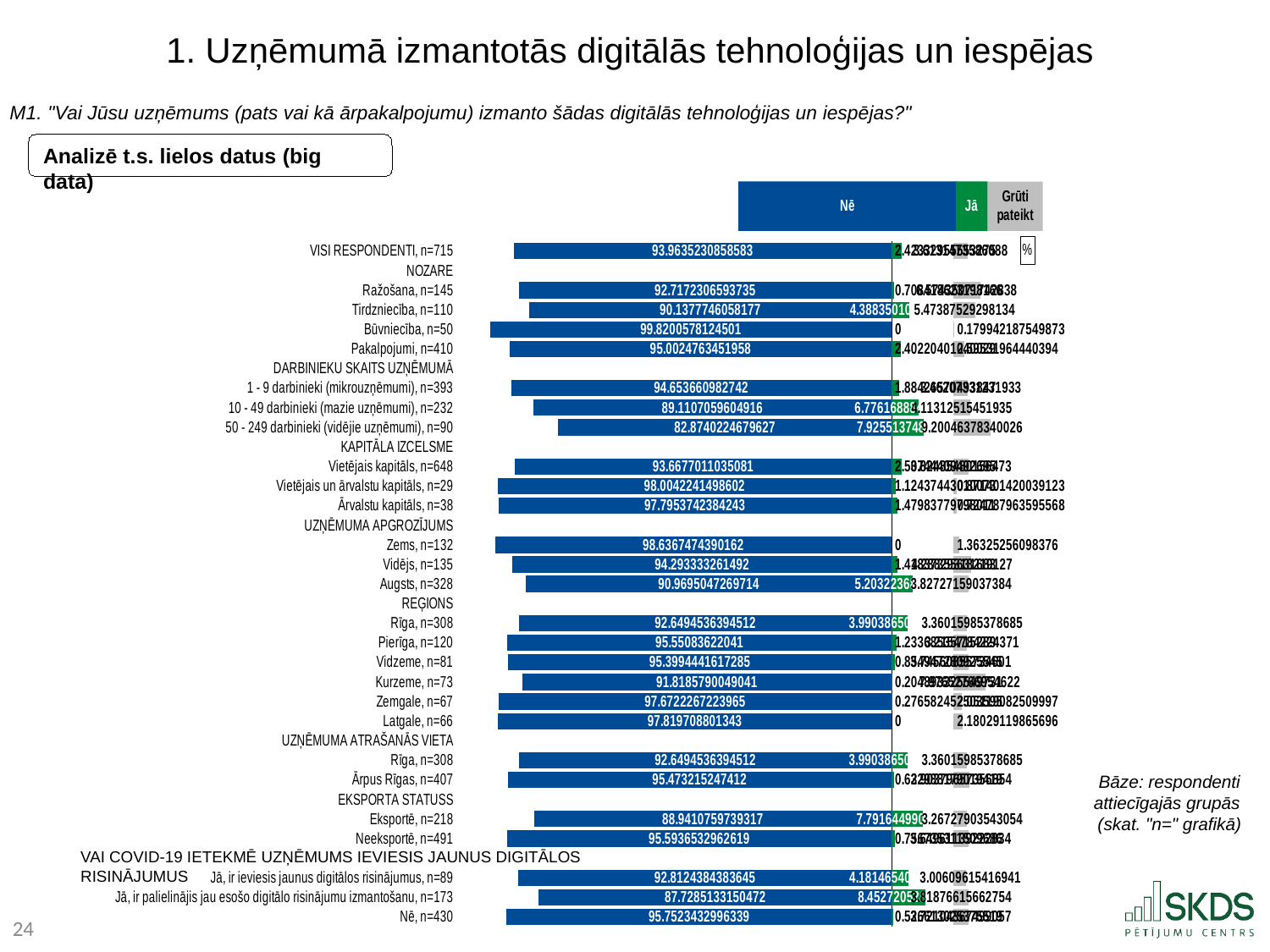
Which group has the lowest "Nē" value? 50 - 249 darbinieki (vidējie uzņēmumi), n=90 What is the "Grūti pateikt" value for Latgale, n=66? 2.18029119865696 What is the "Nē" value for VISI RESPONDENTI, n=715? 93.9635230858583 Which group has the highest "Nē" value? Būvniecība, n=50 Which has the larger "Nē" value: Eksportē, n=218 or Neeksportē, n=491? Neeksportē, n=491 How many series does the chart legend list? 3 What is the title of the chart? Analizē t.s. lielos datus (big data) What are the three legend entries of the chart? Nē, Jā, Grūti pateikt What is the "Nē" value for 50 - 249 darbinieki (vidējie uzņēmumi), n=90? 82.8740224679627 What is the "Nē" value for Būvniecība, n=50? 99.8200578124501 What is the "Jā" value for Būvniecība, n=50? 0 What kind of chart is shown on the slide? bar chart